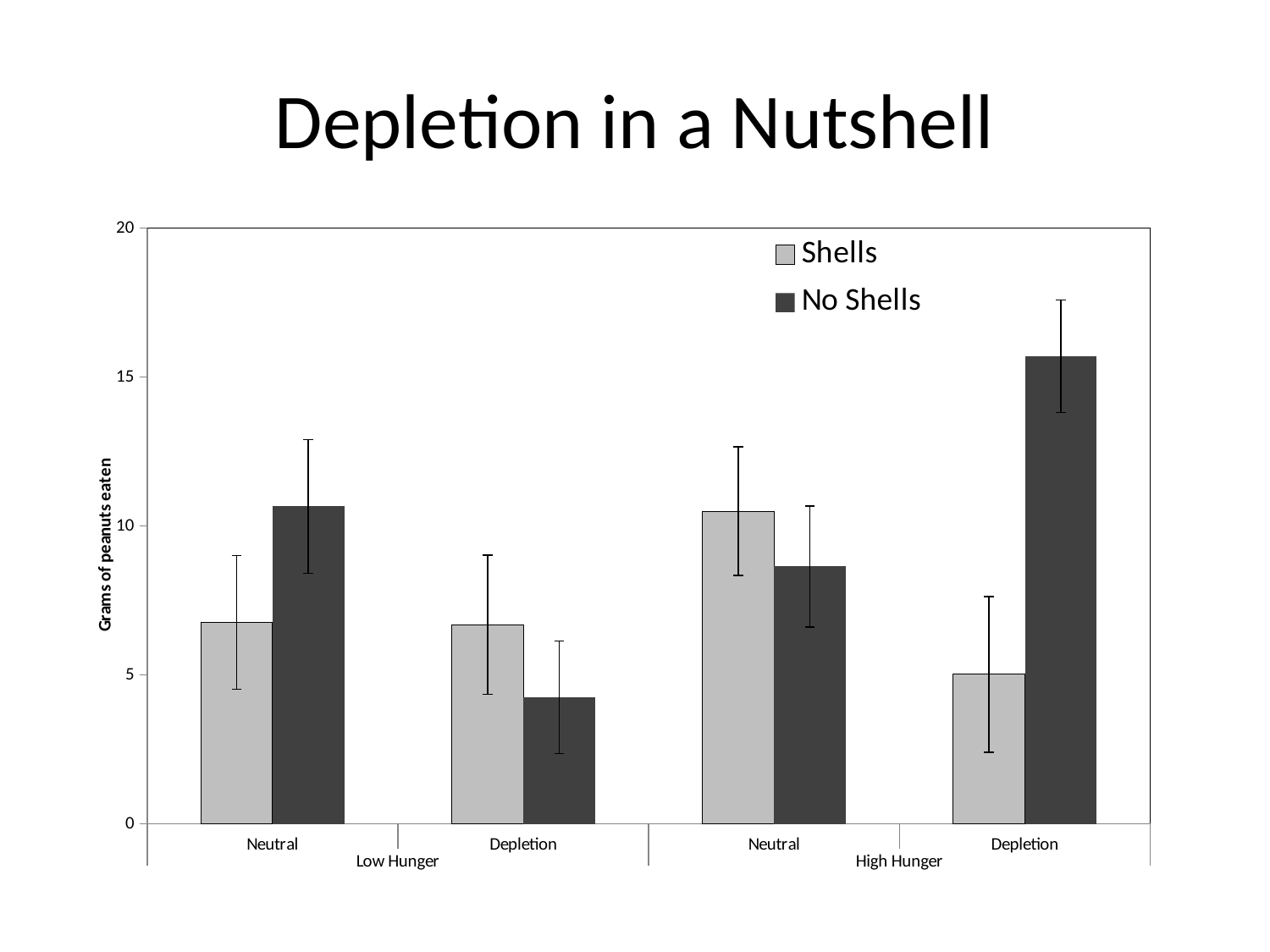
Within the No Shells series, which condition has the lowest value? Low Hunger Depletion How many bars are plotted in the chart? 8 Is the No Shells value for High Hunger Depletion greater or less than 15? greater What is the label of the vertical axis? Grams of peanuts eaten What is the title of the slide? Depletion in a Nutshell Is the Shells value for Low Hunger Neutral greater or less than 10? less Which bar is the highest in the chart? No Shells, High Hunger Depletion In the High Hunger Depletion condition, which is larger: Shells or No Shells? No Shells What kind of chart is shown on the slide? bar chart In the Low Hunger Depletion condition, which is larger: Shells or No Shells? Shells How many series does the legend list? 2 Is the No Shells value for Low Hunger Depletion greater or less than 5? less